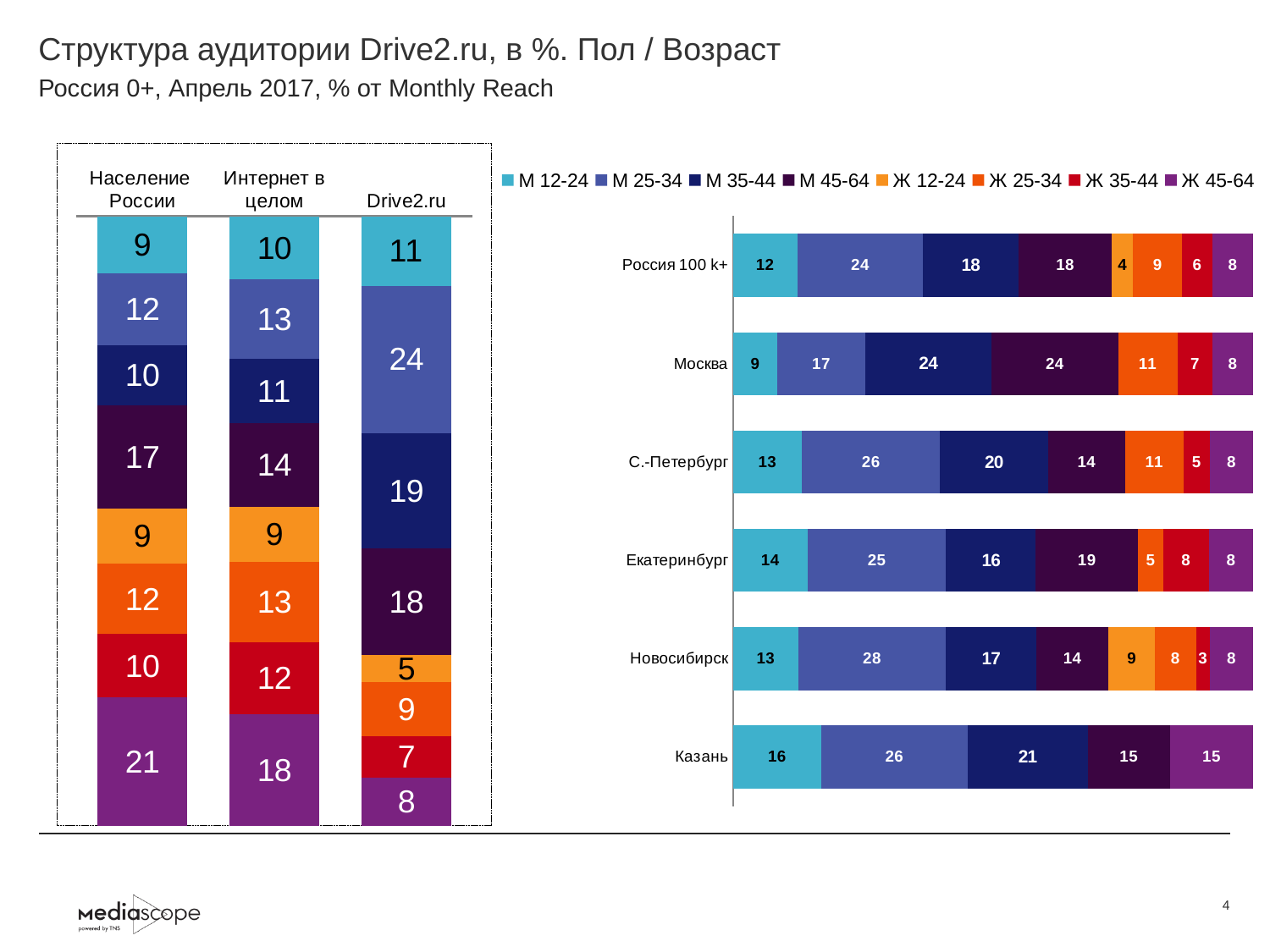
In the right chart, what is the value of the М 35-44 segment for Москва? 24 In the right chart, how many series does the legend list? 8 In the right chart, what is the value of the М 12-24 segment for Россия 100 k+? 12 What kind of chart is the chart on the right side of the slide? Stacked bar chart In the right chart, which category has the highest М 25-34 value? Новосибирск In the right chart, what is the value of the М 25-34 segment for Казань? 26 In the left chart, what is the value of the М 25-34 segment for Drive2.ru? 24 In the left chart, how many bars (categories) are shown? 3 In the left chart, what is the value of the Ж 45-64 segment for Население России? 21 In the right chart, how many categories (rows) are shown? 6 In the left chart, which is larger: the Ж 12-24 value for Интернет в целом or for Drive2.ru? Интернет в целом In the left chart, what is the difference between the М 25-34 values for Drive2.ru and Население России? 12